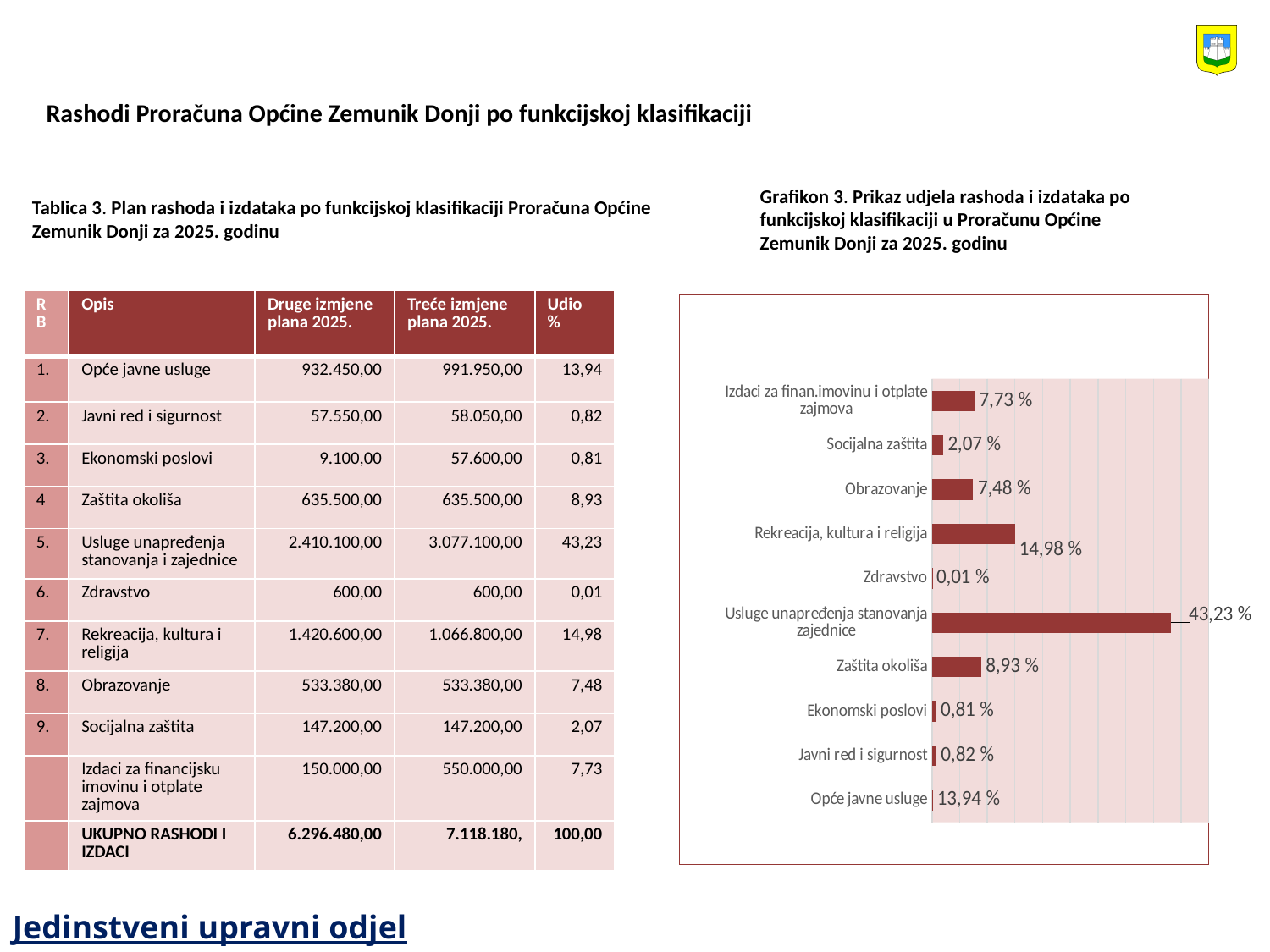
In Grafikon 3, what is the value for Zaštita okoliša? 8,93 % Which category has the highest value in Grafikon 3? Usluge unapređenja stanovanja zajednice In Grafikon 3, what is the difference between the values for Obrazovanje and Izdaci za finan.imovinu i otplate zajmova? 0,25 % In Grafikon 3, what is the value for Rekreacija, kultura i religija? 14,98 % In Grafikon 3, what is the value for Socijalna zaštita? 2,07 % In Grafikon 3, what is the value for Izdaci za finan.imovinu i otplate zajmova? 7,73 % What is the title of the chart on the slide? Grafikon 3. Prikaz udjela rashoda i izdataka po funkcijskoj klasifikaciji u Proračunu Općine Zemunik Donji za 2025. godinu Which category has the lowest value in Grafikon 3? Zdravstvo How many categories are shown in Grafikon 3? 10 In Grafikon 3, which is larger: the value for Obrazovanje or the value for Zaštita okoliša? Zaštita okoliša What kind of chart is Grafikon 3? bar chart In Grafikon 3, what is the difference between the values for Usluge unapređenja stanovanja zajednice and Rekreacija, kultura i religija? 28,25 %